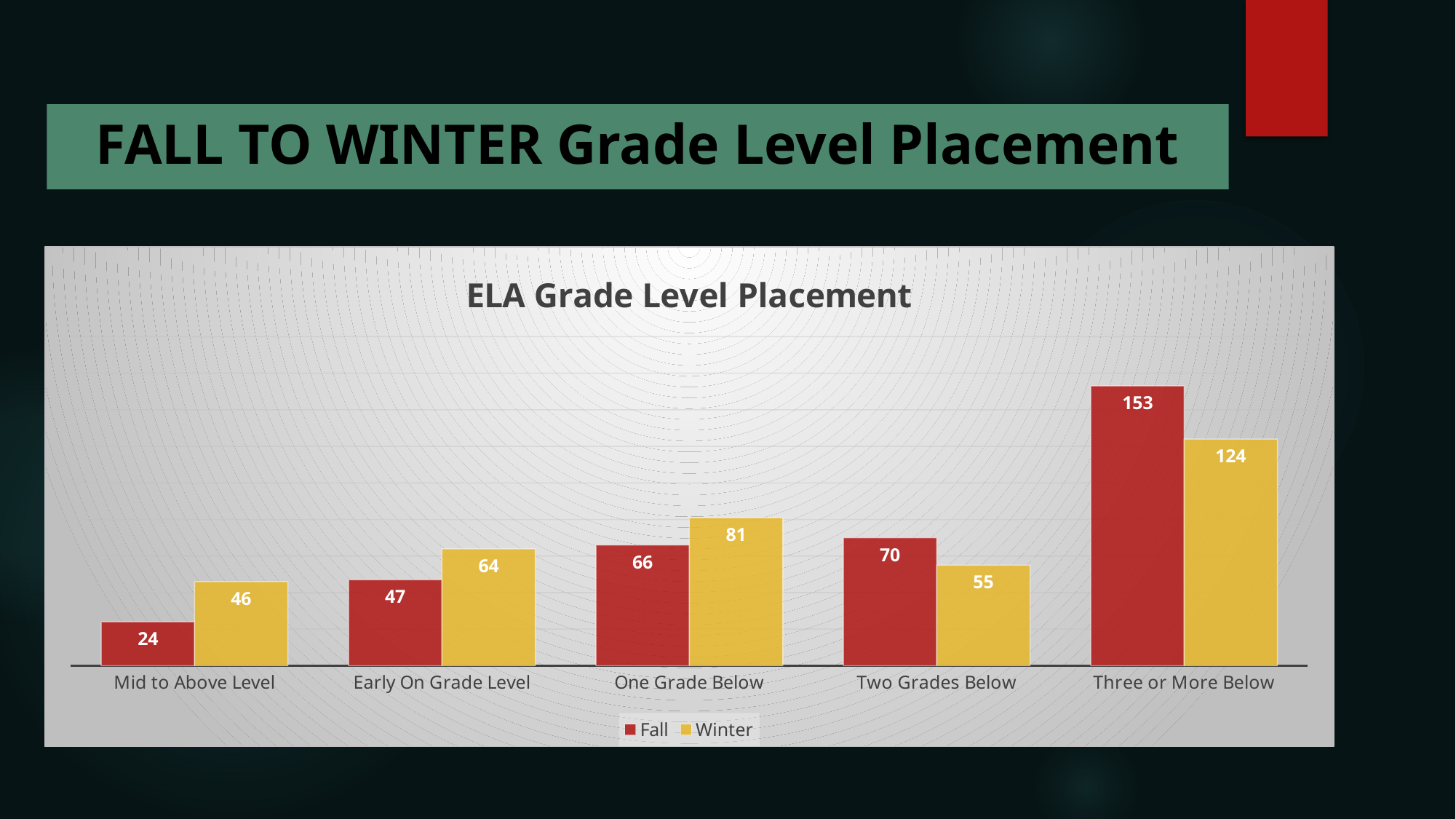
What is the Winter value for One Grade Below? 81 Which category has the lowest Winter value? Mid to Above Level How many series does the legend list? 2 What kind of chart is shown? Bar chart What is the difference between the Winter and Fall values for Mid to Above Level? 22 What is the difference between the Fall and Winter values for Three or More Below? 29 How many categories are shown on the x axis? 5 Which category has the highest Fall value? Three or More Below Which is larger for Two Grades Below, the Fall value or the Winter value? Fall What is the title of the chart? ELA Grade Level Placement What is the Winter value for Three or More Below? 124 What is the Fall value for Mid to Above Level? 24